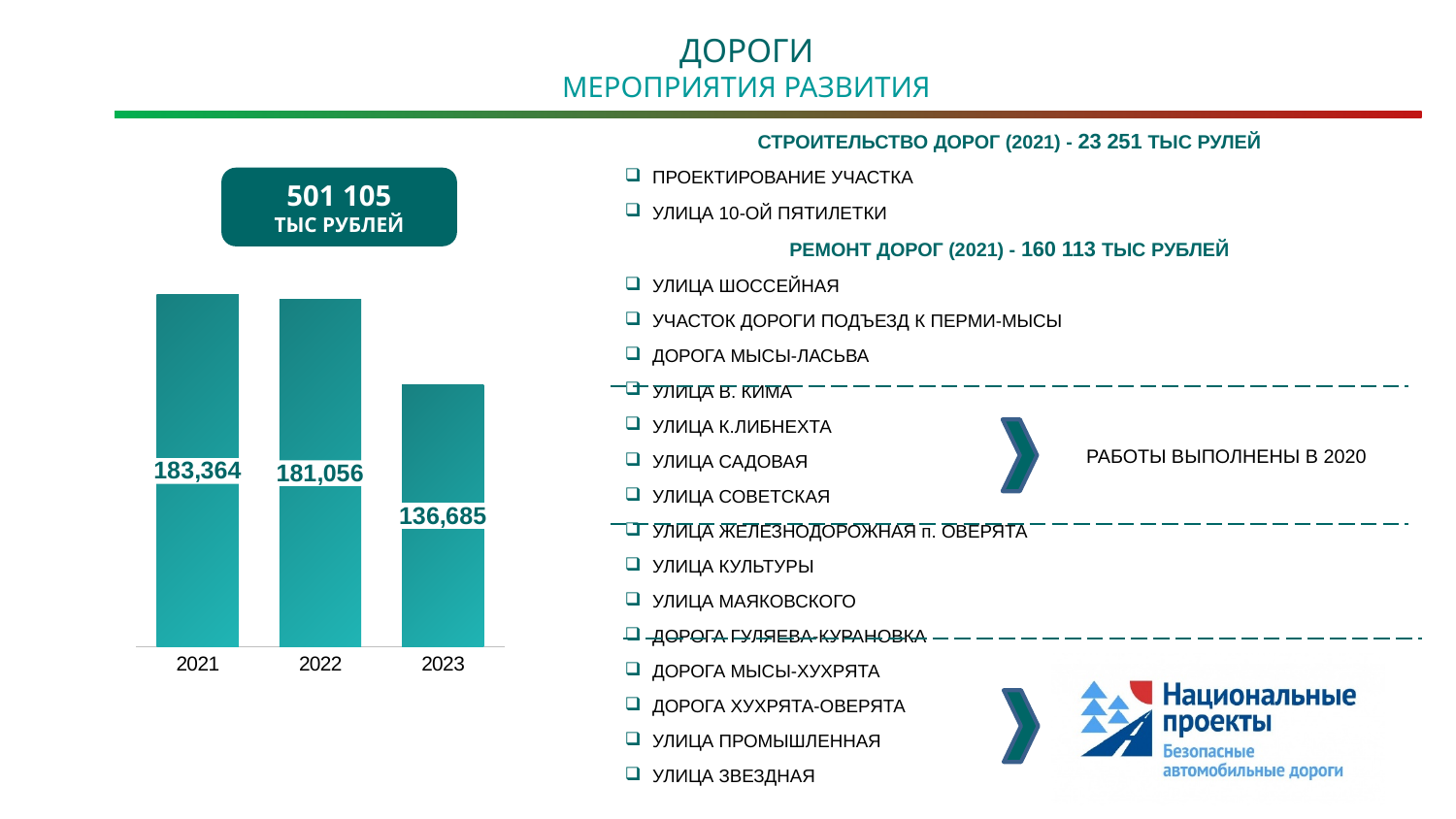
What is the difference between the values for 2021 and 2023? 46,679 Which year has the highest value in the bar chart? 2021 What is the value for 2022 in the bar chart? 181,056 What total amount in thousand rubles is shown in the box above the bar chart? 501 105 What is the value for 2023 in the bar chart? 136,685 How many years are shown in the bar chart? 3 Which year has the lowest value in the bar chart? 2023 Do the values rise or fall from 2021 to 2023? fall What is the value for 2021 in the bar chart? 183,364 What is the difference between the values for 2021 and 2022? 2,308 What kind of chart is shown on the slide? bar chart Which is larger, the value for 2022 or the value for 2023? 2022